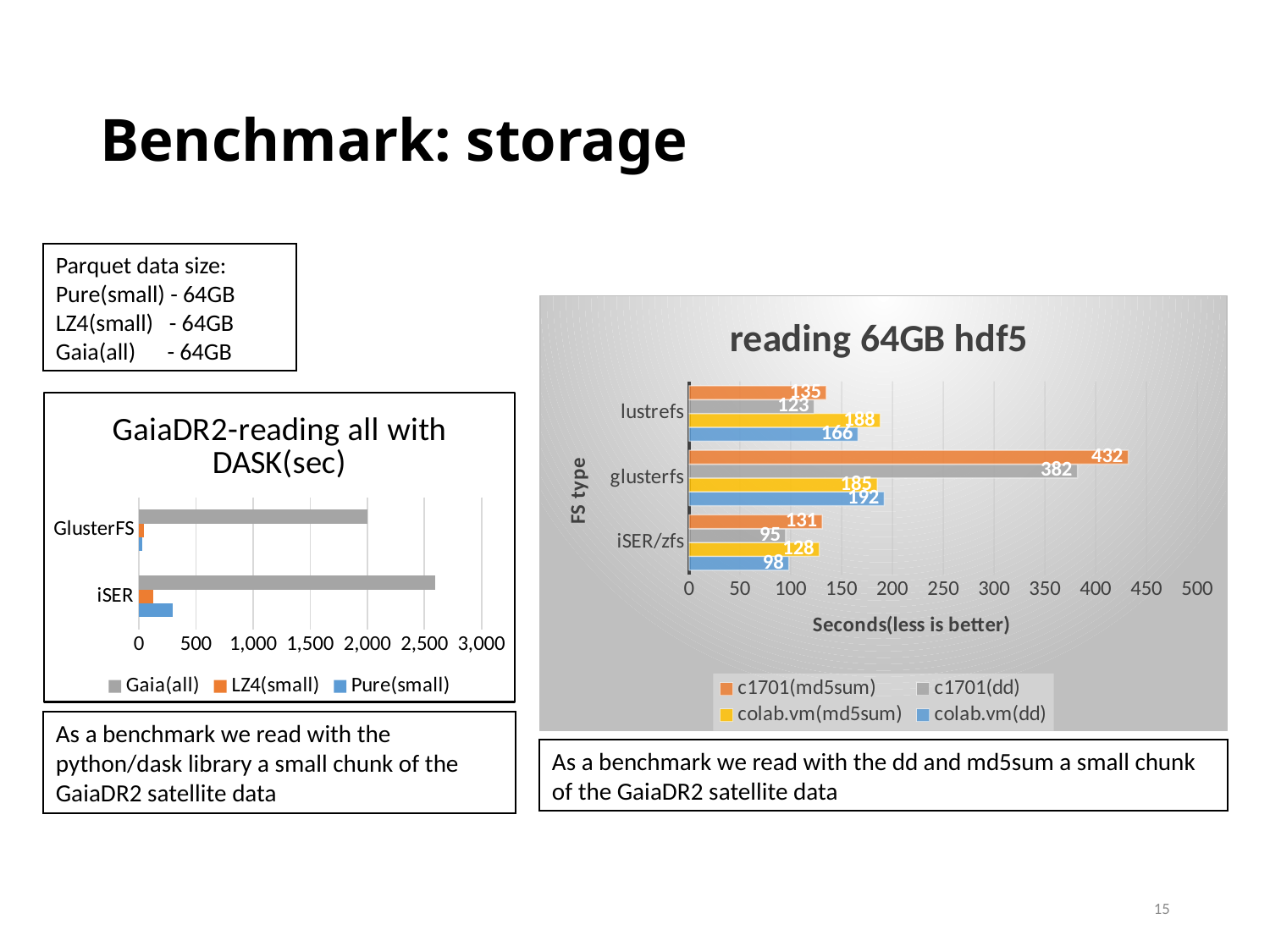
In the 'reading 64GB hdf5' chart, which is larger for lustrefs: colab.vm(md5sum) or colab.vm(dd)? colab.vm(md5sum) How many FS types are shown in the 'reading 64GB hdf5' chart? 3 How many series does the legend of the 'reading 64GB hdf5' chart list? 4 In the 'reading 64GB hdf5' chart, what is the colab.vm(dd) value for iSER/zfs? 98 What kind of chart is the 'GaiaDR2-reading all with DASK(sec)' chart? bar chart In the 'reading 64GB hdf5' chart, what is the colab.vm(md5sum) value for lustrefs? 188 In the 'reading 64GB hdf5' chart, what is the difference between the c1701(md5sum) and c1701(dd) values for glusterfs? 50 In the 'GaiaDR2-reading all with DASK(sec)' chart, is the Gaia(all) value for iSER greater or less than 2,500? greater In the 'reading 64GB hdf5' chart, which FS type has the lowest c1701(md5sum) value? iSER/zfs What is the x-axis title of the 'reading 64GB hdf5' chart? Seconds(less is better) In the 'reading 64GB hdf5' chart, which FS type has the highest c1701(dd) value? glusterfs In the 'reading 64GB hdf5' chart, what is the c1701(md5sum) value for glusterfs? 432